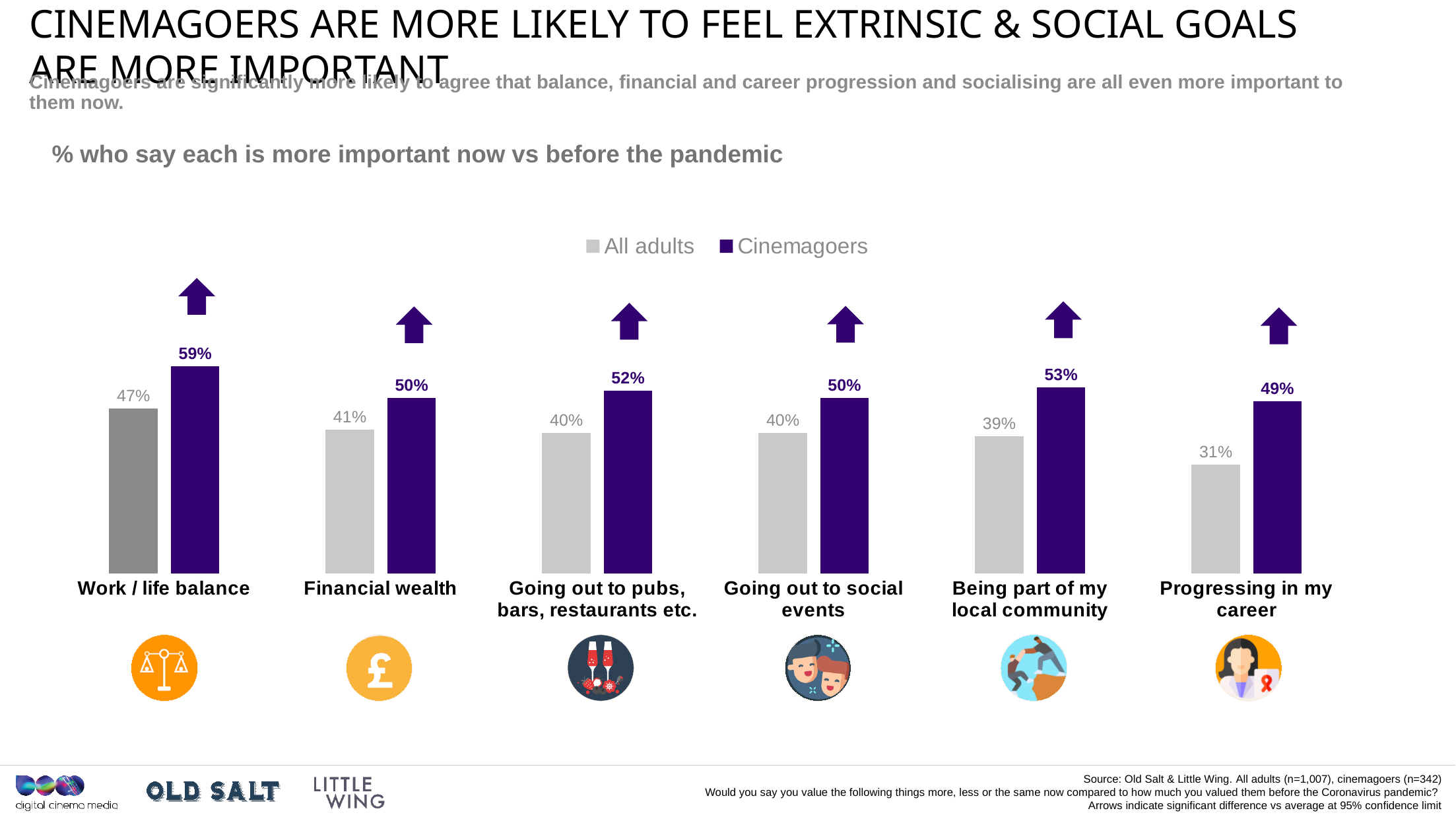
Which category has the highest value for cinemagoers? Work / life balance Which series is shown in purple in the legend? Cinemagoers What is the difference between cinemagoers and all adults for progressing in my career? 18 percentage points What percentage of all adults say progressing in my career is more important now? 31% Which is larger: the cinemagoers value for financial wealth or the cinemagoers value for going out to pubs, bars, restaurants etc.? Going out to pubs, bars, restaurants etc. What kind of chart is shown on the slide? Bar chart What is the difference between cinemagoers and all adults for work / life balance? 12 percentage points Which category has the lowest value for all adults? Progressing in my career What percentage of all adults say being part of my local community is more important now? 39% What percentage of cinemagoers say work / life balance is more important now? 59% How many series does the legend list? 2 How many categories are shown on the chart? 6